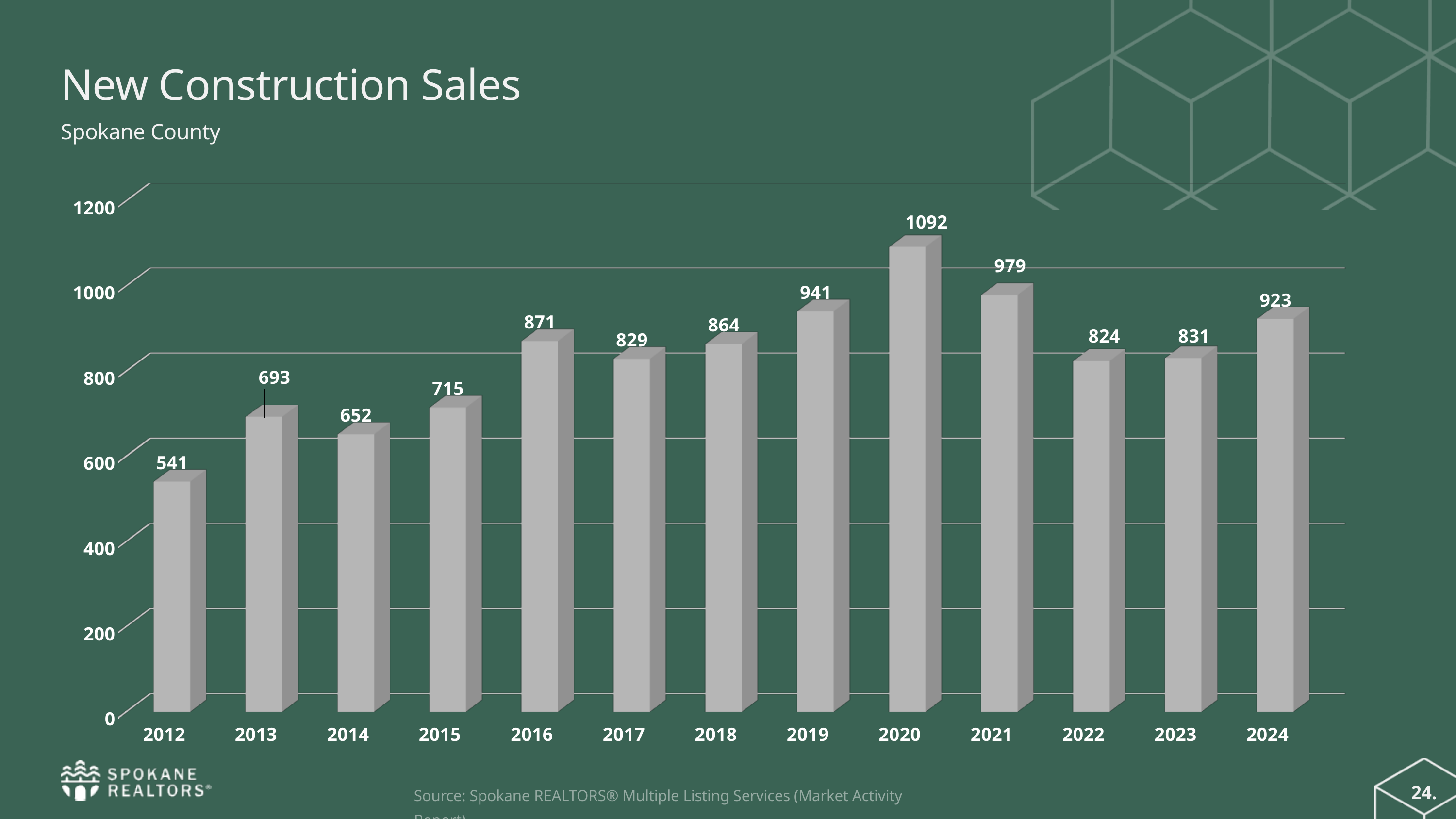
What was the number of new construction sales in 2024? 923 Is the value for 2019 greater or less than 800? greater What was the number of new construction sales in 2020? 1092 Which year had more new construction sales, 2016 or 2017? 2016 Which year had the highest number of new construction sales? 2020 What is the difference in new construction sales between 2024 and 2023? 92 What was the number of new construction sales in 2012? 541 Which year had the lowest number of new construction sales? 2012 What is the difference in new construction sales between 2020 and 2021? 113 What is the title of the chart on the slide? New Construction Sales What kind of chart is shown on the slide? Bar chart How many years are shown on the chart? 13